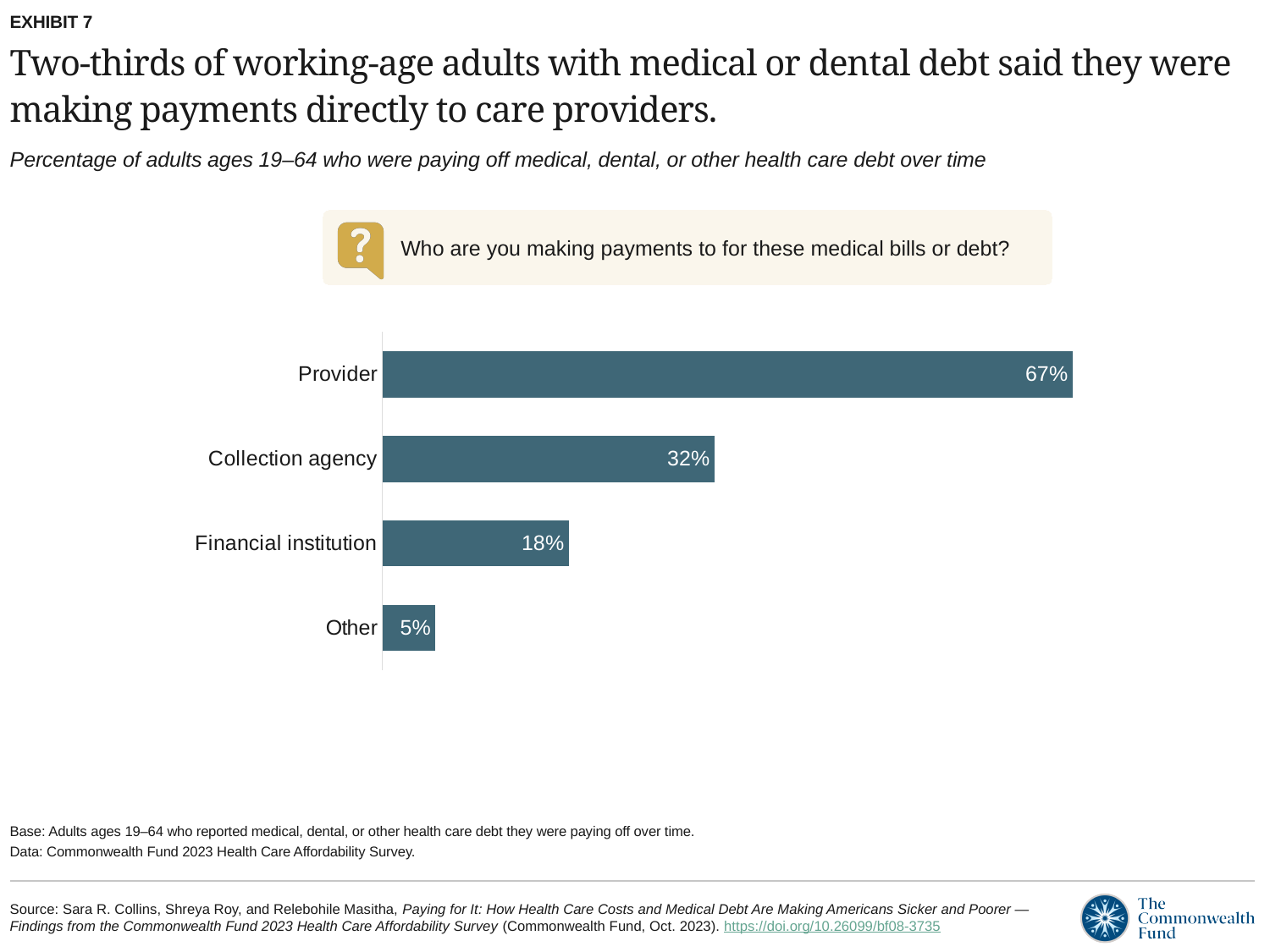
Which category has the highest percentage? Provider What percentage of adults said they were making payments to a provider? 67% What is the difference in percentage points between Provider and Collection agency? 35 What percentage of adults said they were making payments to a financial institution? 18% Which category has the lowest percentage? Other What percentage of adults said they were making payments to a collection agency? 32% What percentage of adults said they were making payments to 'Other'? 5% What is the difference in percentage points between Collection agency and Financial institution? 14 What type of chart is shown on the slide? Bar chart What survey question is shown in the box above the chart? Who are you making payments to for these medical bills or debt? Which is larger, the value for Financial institution or the value for Other? Financial institution How many categories are shown in the chart? 4